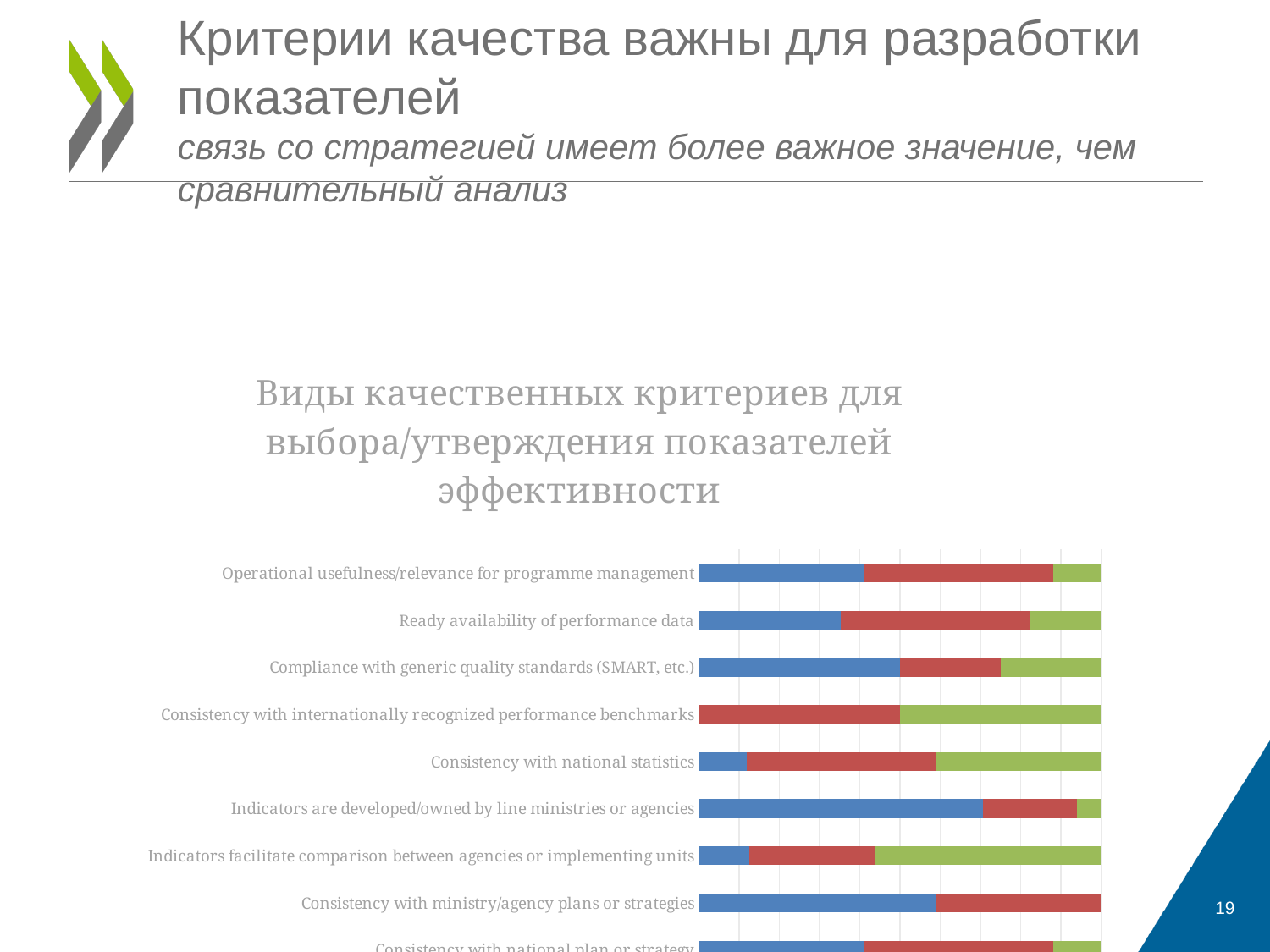
Which category appears at the top of the chart? Operational usefulness/relevance for programme management How many coloured segments make up each bar in the chart? 3 What kind of chart is shown on the slide? Stacked bar chart Which category has no green segment? Consistency with ministry/agency plans or strategies How many categories are listed on the chart's vertical axis? 9 Which category has the largest blue segment? Indicators are developed/owned by line ministries or agencies What is the title of the chart? Виды качественных критериев для выбора/утверждения показателей эффективности Which category has no blue segment at all? Consistency with internationally recognized performance benchmarks Is the green segment larger for 'Indicators facilitate comparison between agencies or implementing units' or for 'Indicators are developed/owned by line ministries or agencies'? Indicators facilitate comparison between agencies or implementing units Is the blue segment larger for 'Operational usefulness/relevance for programme management' or for 'Consistency with national statistics'? Operational usefulness/relevance for programme management